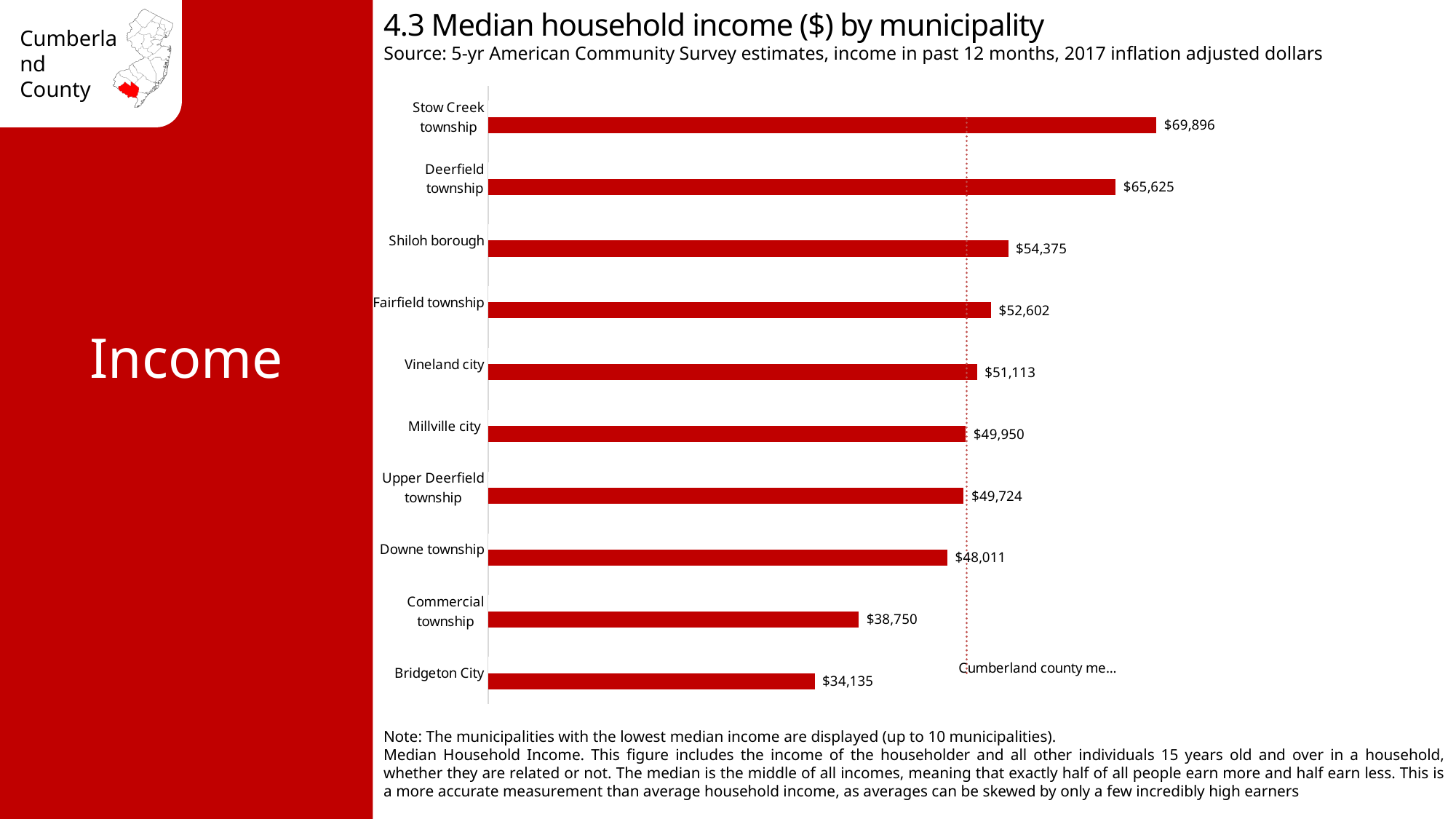
Which has a higher median household income, Millville city or Upper Deerfield township? Millville city Which municipality has the highest median household income on the chart? Stow Creek township How many municipalities are shown on the chart? 10 What is the median household income for Stow Creek township? $69,896 What is the median household income for Commercial township? $38,750 What is the title of the chart? 4.3 Median household income ($) by municipality What is the difference in median household income between Deerfield township and Shiloh borough? $11,250 What is the median household income for Vineland city? $51,113 Which municipality has the lowest median household income on the chart? Bridgeton City What kind of chart is used to show median household income by municipality? Bar chart What is the median household income for Bridgeton City? $34,135 What is the difference in median household income between Stow Creek township and Bridgeton City? $35,761